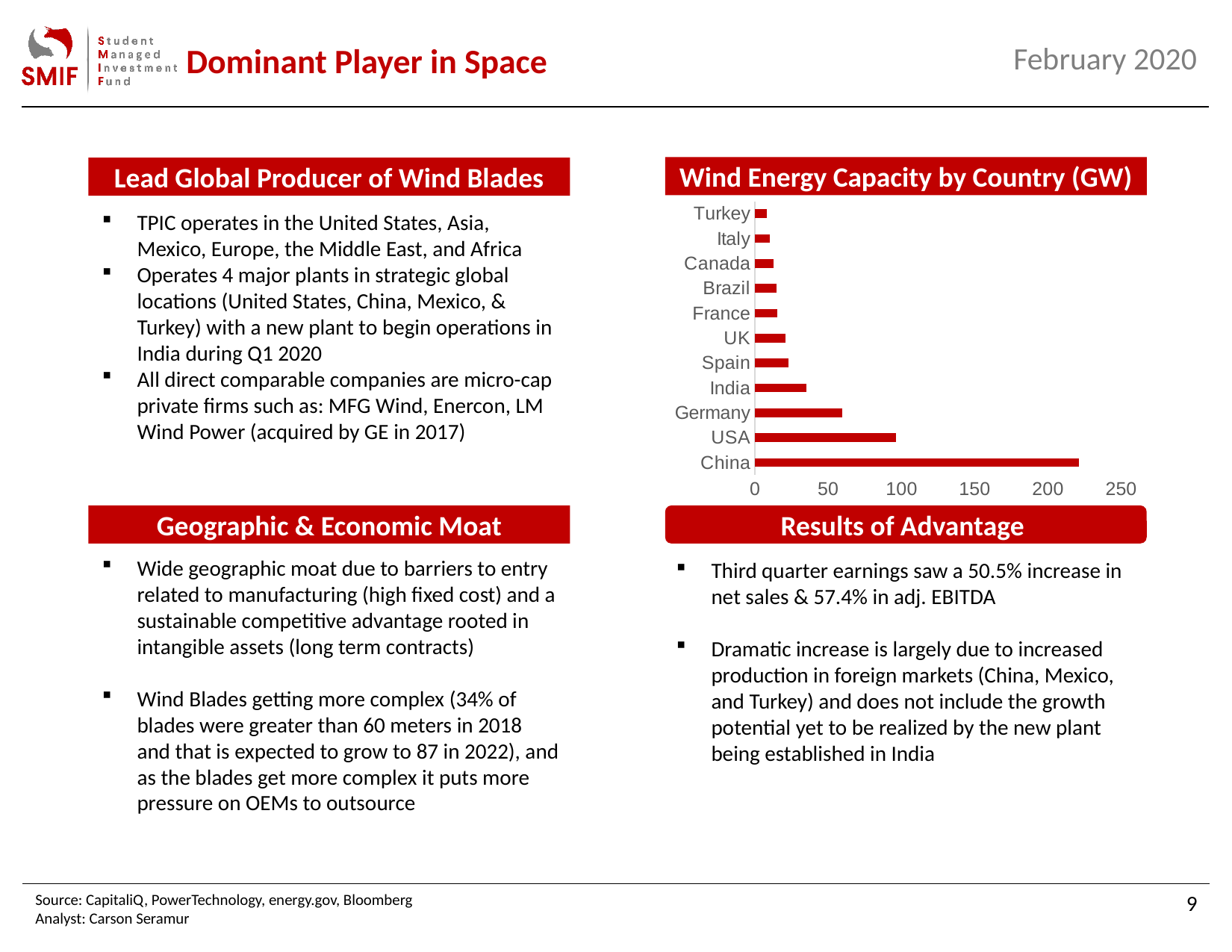
Which country has a larger wind energy capacity, India or Spain? India Is the wind energy capacity for China greater or less than 200 GW? greater What unit is wind energy capacity measured in on the chart? GW Is the wind energy capacity for Germany greater or less than 50 GW? greater Which country has a larger wind energy capacity, the USA or Germany? USA What type of chart is shown on the slide? bar chart How many countries are shown in the Wind Energy Capacity by Country chart? 11 What is the title of the chart on the slide? Wind Energy Capacity by Country (GW) Is the wind energy capacity for India greater or less than 50 GW? less Which country has the lowest wind energy capacity in the chart? Turkey Which country has the highest wind energy capacity in the chart? China